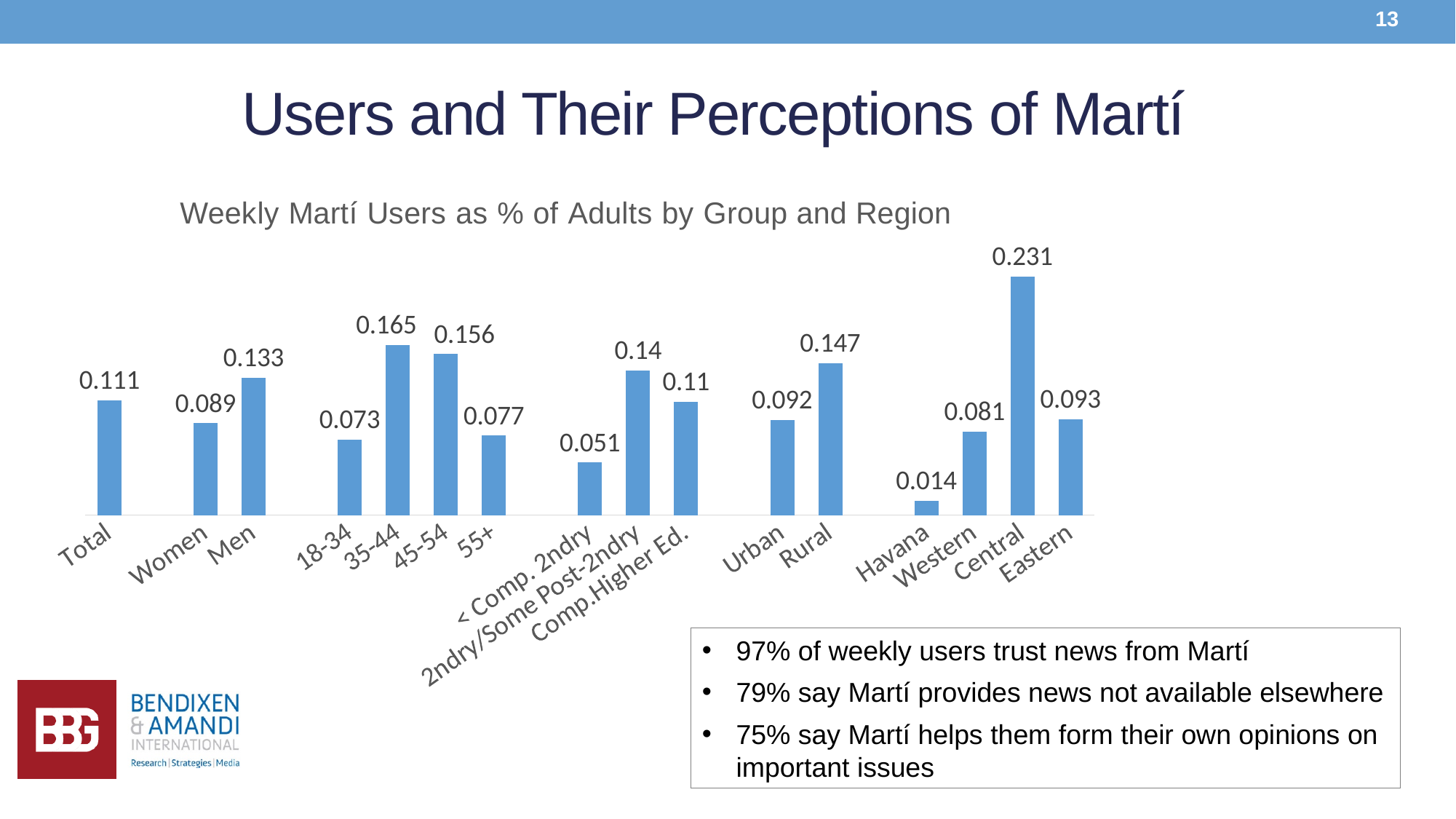
What kind of chart is shown on the slide? Bar chart What is the value for 35-44? 0.165 What is the value for Havana? 0.014 Which is larger, the value for 18-34 or the value for 55+? 55+ Which category has the highest value? Central Which category has the lowest value? Havana What is the title of the chart? Weekly Martí Users as % of Adults by Group and Region How many categories are shown in the chart? 16 What is the difference between the values for Men and Women? 0.044 What is the value for Women? 0.089 What is the value for Central? 0.231 What is the difference between the values for Rural and Urban? 0.055